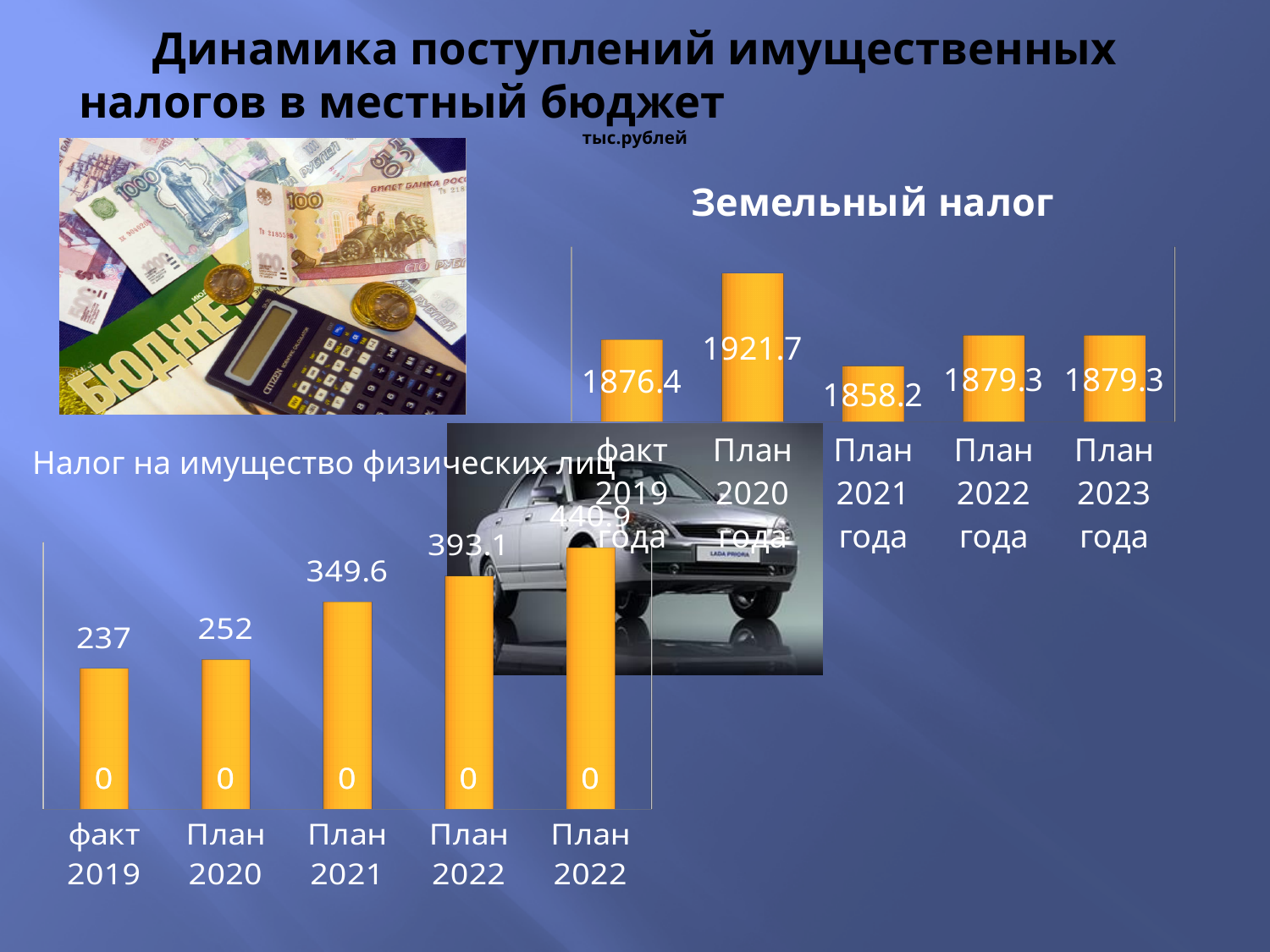
In the 'Земельный налог' chart, what is the difference between План 2020 года and факт 2019 года? 45.3 In the 'Налог на имущество физических лиц' chart, what is the difference between План 2020 and факт 2019? 15 In the 'Налог на имущество физических лиц' chart, what is the value for План 2021? 349.6 How many bars are in the 'Земельный налог' chart? 5 In the 'Налог на имущество физических лиц' chart, what is the highest value shown? 440.9 In the 'Земельный налог' chart, which category has the highest value? План 2020 года In the 'Земельный налог' chart, which category has the lowest value? План 2021 года In the 'Налог на имущество физических лиц' chart, what is the value for факт 2019? 237 In the 'Земельный налог' chart, what is the value for План 2020 года? 1921.7 In the 'Земельный налог' chart, what is the value for факт 2019 года? 1876.4 In the 'Налог на имущество физических лиц' chart, do the values rise or fall from left to right? rise In the 'Земельный налог' chart, which is larger: факт 2019 года or План 2021 года? факт 2019 года